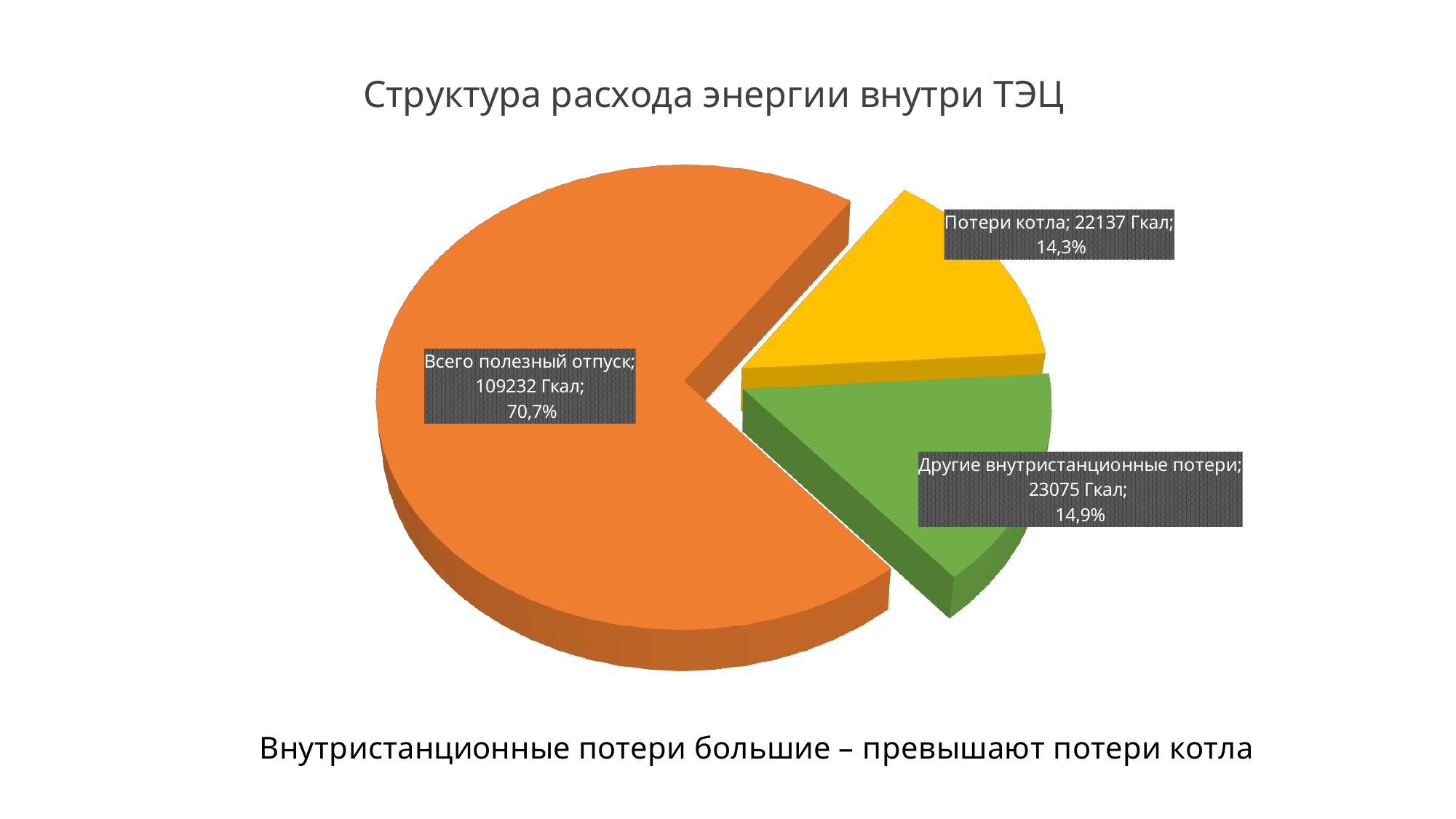
What is the difference in Гкал between Другие внутристанционные потери and Потери котла? 938 Гкал What is the title of the chart? Структура расхода энергии внутри ТЭЦ What type of chart is shown on the slide? Pie chart Which category has the smallest slice? Потери котла What is the value for Другие внутристанционные потери? 23075 Гкал What share of the pie does Потери котла take? 14,3% What share of the pie does Всего полезный отпуск take? 70,7% What share of the pie does Другие внутристанционные потери take? 14,9% How many slices does the pie chart have? 3 What is the value for Всего полезный отпуск? 109232 Гкал What is the value for Потери котла? 22137 Гкал Which category has the largest slice? Всего полезный отпуск